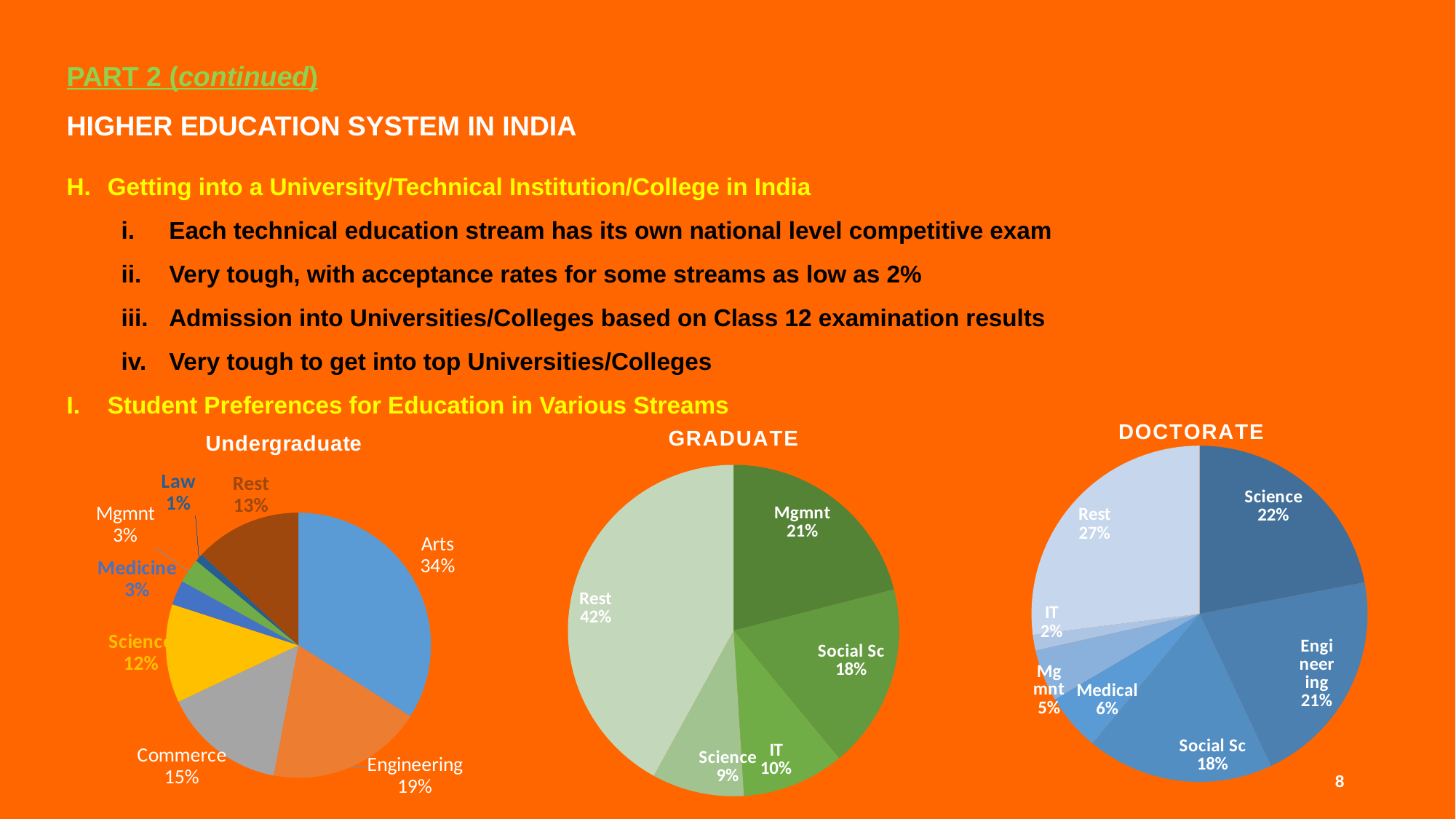
In the Undergraduate pie chart, which stream has the smallest share? Law How many slices does the Graduate pie chart have? 5 In the Graduate pie chart, which is larger, IT or Science? IT How many slices does the Undergraduate pie chart have? 8 What type of chart is used for the Doctorate data? Pie chart In the Doctorate pie chart, what is the difference between the Medical and Mgmnt shares? 1% In the Graduate pie chart, what share is Social Sc? 18% In the Graduate pie chart, which slice is the largest? Rest In the Undergraduate pie chart, what is the difference between the Engineering and Commerce shares? 4% In the Undergraduate pie chart, what share is Arts? 34% In the Doctorate pie chart, what share is Engineering? 21% In the Doctorate pie chart, which stream has the smallest share? IT